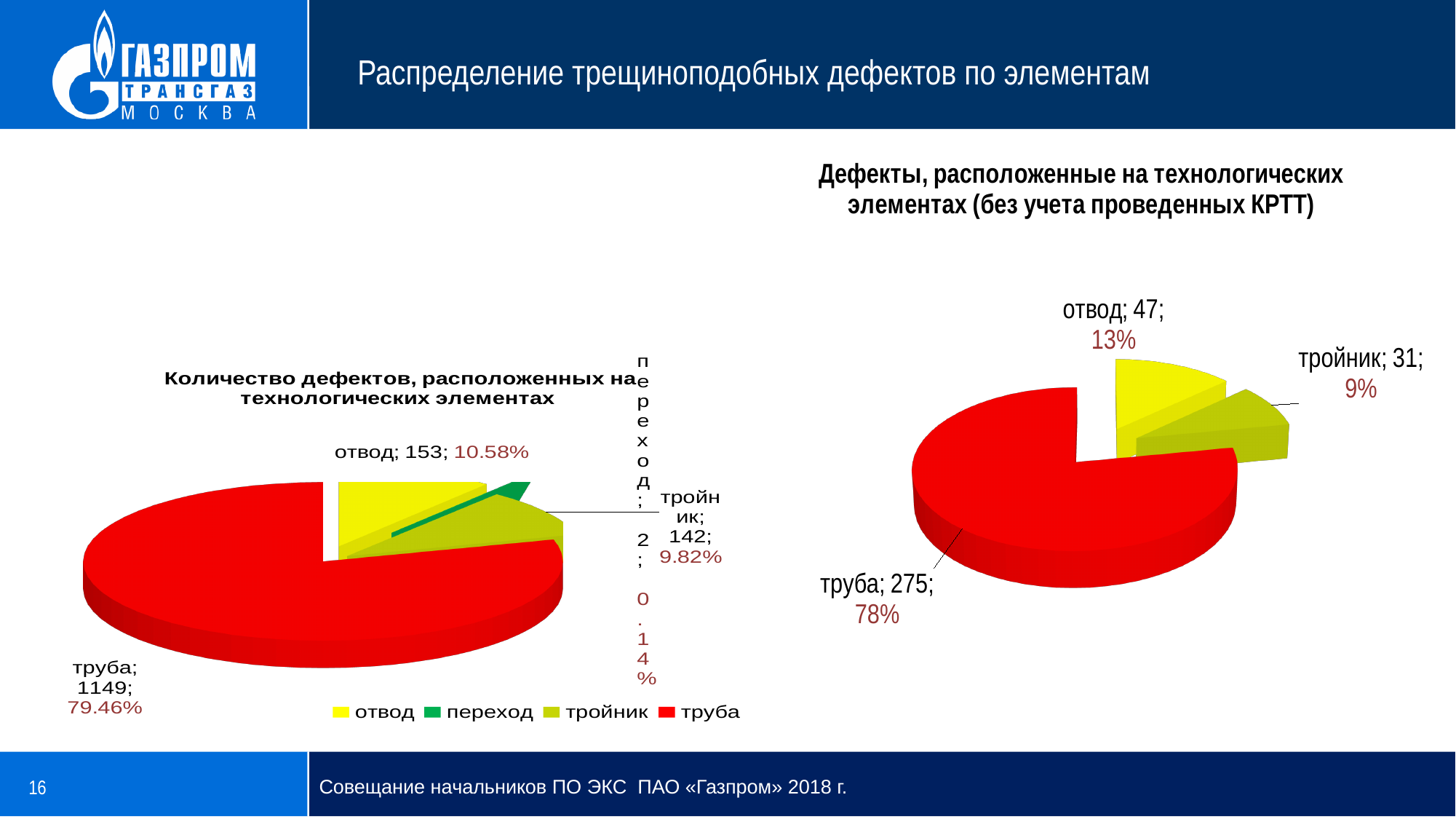
In the right chart 'Дефекты, расположенные на технологических элементах (без учета проведенных КРТТ)', which is larger, отвод or тройник? отвод In the left chart 'Количество дефектов, расположенных на технологических элементах', what share of the pie does отвод have? 10.58% In the left chart 'Количество дефектов, расположенных на технологических элементах', which category has the smallest value? переход In the right chart 'Дефекты, расположенные на технологических элементах (без учета проведенных КРТТ)', how many categories are shown? 3 In the right chart 'Дефекты, расположенные на технологических элементах (без учета проведенных КРТТ)', which category has the largest value? труба In the left chart 'Количество дефектов, расположенных на технологических элементах', what is the value for труба? 1149 In the left chart 'Количество дефектов, расположенных на технологических элементах', how many entries does the legend list? 4 In the right chart 'Дефекты, расположенные на технологических элементах (без учета проведенных КРТТ)', what is the value for труба? 275 In the left chart 'Количество дефектов, расположенных на технологических элементах', what is the value for переход? 2 In the right chart 'Дефекты, расположенные на технологических элементах (без учета проведенных КРТТ)', what share of the pie does тройник have? 9% What type of chart is the right chart 'Дефекты, расположенные на технологических элементах (без учета проведенных КРТТ)'? pie chart In the left chart 'Количество дефектов, расположенных на технологических элементах', what is the difference between the values for отвод and тройник? 11